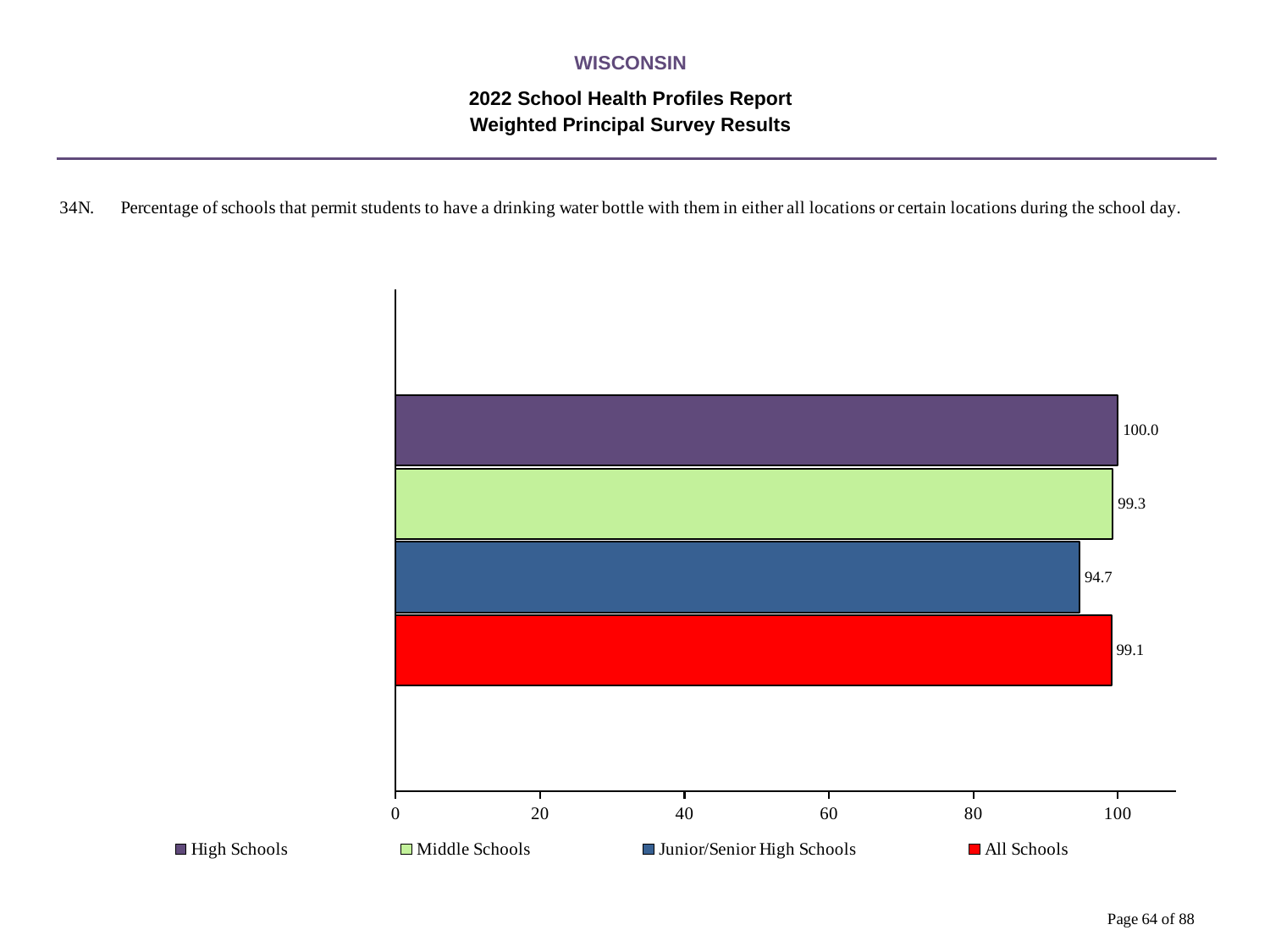
What is the value for Junior/Senior High Schools? 94.7 How many series does the legend list? 4 What kind of chart is shown on the slide? Bar chart Which school type has the lowest value? Junior/Senior High Schools What is the value for High Schools? 100.0 Which school type has the highest value? High Schools What colour is the bar for All Schools? Red What is the value for All Schools? 99.1 What is the difference between the values for High Schools and Junior/Senior High Schools? 5.3 What is the difference between the values for Middle Schools and All Schools? 0.2 Which is larger, the value for Middle Schools or the value for Junior/Senior High Schools? Middle Schools What is the value for Middle Schools? 99.3